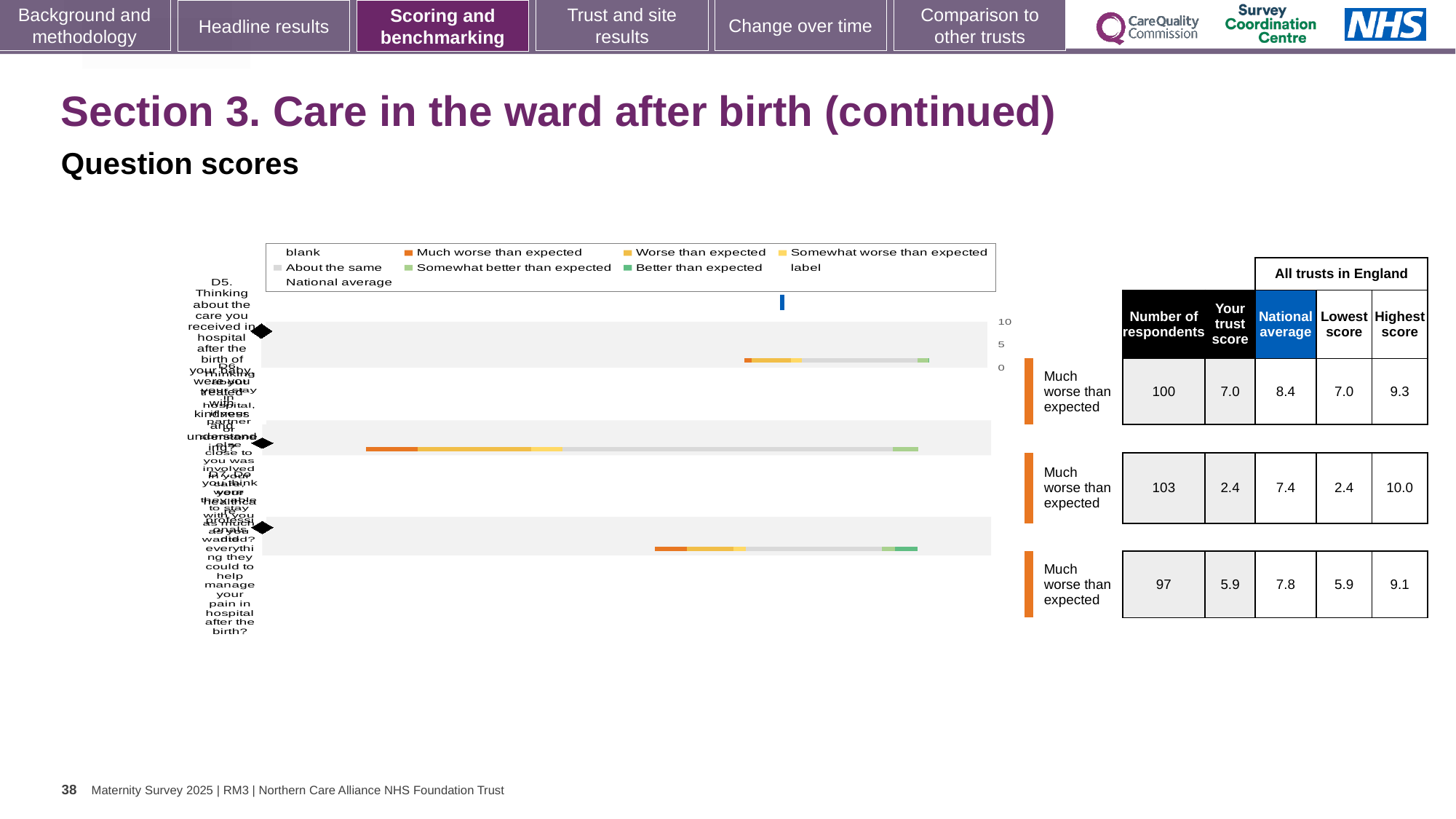
What benchmark rating is shown next to each of the three bars? Much worse than expected How many entries does the chart legend list? 9 In the table, what is the 'Your trust score' for the second row? 2.4 What kind of chart is shown on the slide? bar chart In the table, what is the national average for the third row? 7.8 In the second table row, what is the difference between the national average and the trust score? 5.0 Which table row has the lowest 'Your trust score'? the second row (2.4) In the table, what is the number of respondents for the first row? 100 How many question rows (bars) are plotted in the chart? 3 Is the trust score in the first table row larger or smaller than the trust score in the third row? larger Which table row has the highest 'Your trust score'? the first row (7.0) In the table, what is the highest score for the second row? 10.0